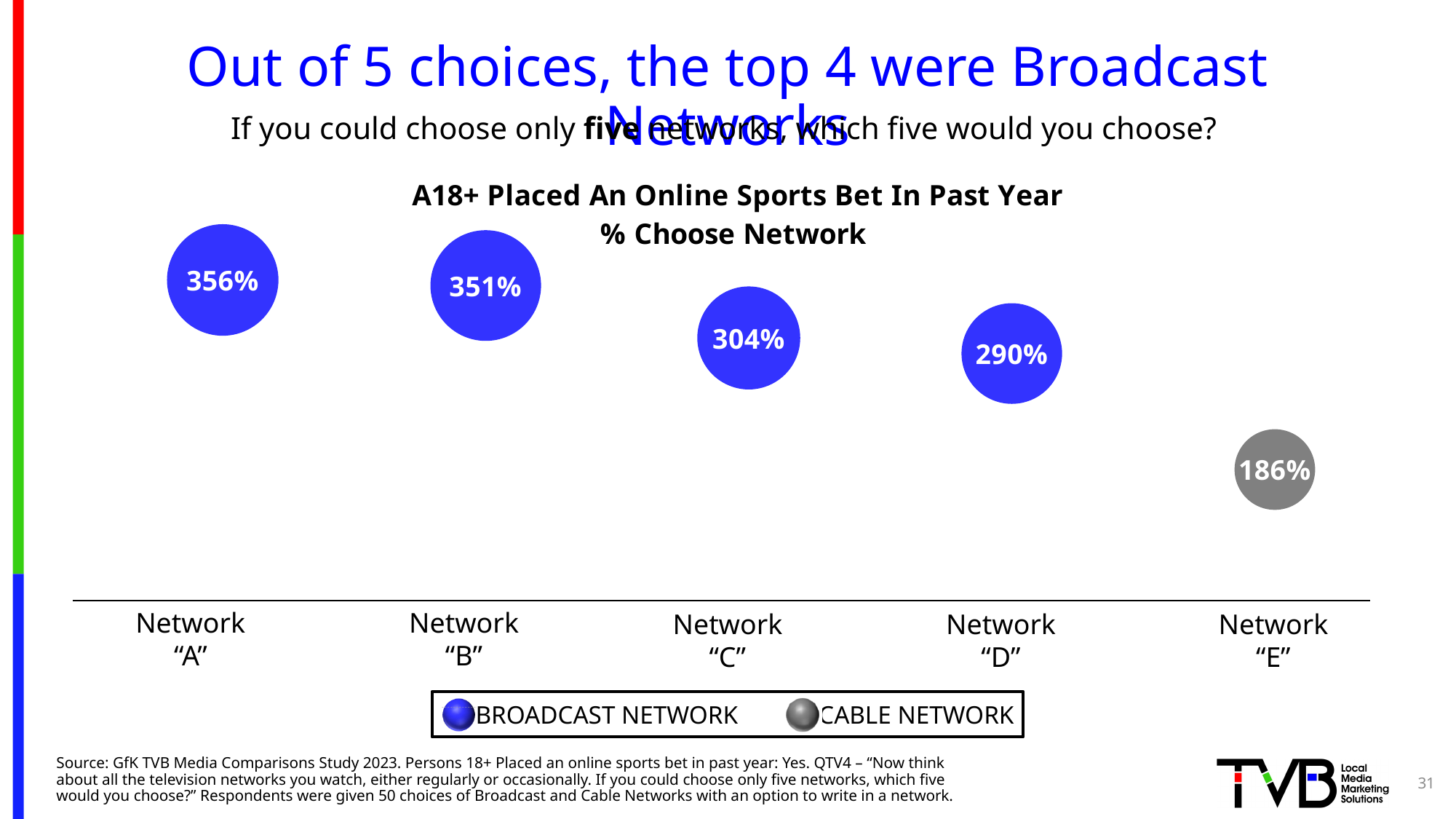
Which network has the lowest value? Network "E" Which is larger, the value for Network "C" or Network "D"? Network "C" What is the difference between the values for Network "D" and Network "E"? 104% Do the values rise or fall from Network "A" to Network "E"? fall Which network has the highest value? Network "A" What is the difference between the values for Network "A" and Network "B"? 5% How many series does the legend list? 2 Which network is shown as a Cable Network in the chart? Network "E" What is the value for Network "E"? 186% What is the value for Network "A"? 356% What is the value for Network "C"? 304% How many networks are shown in the chart? 5